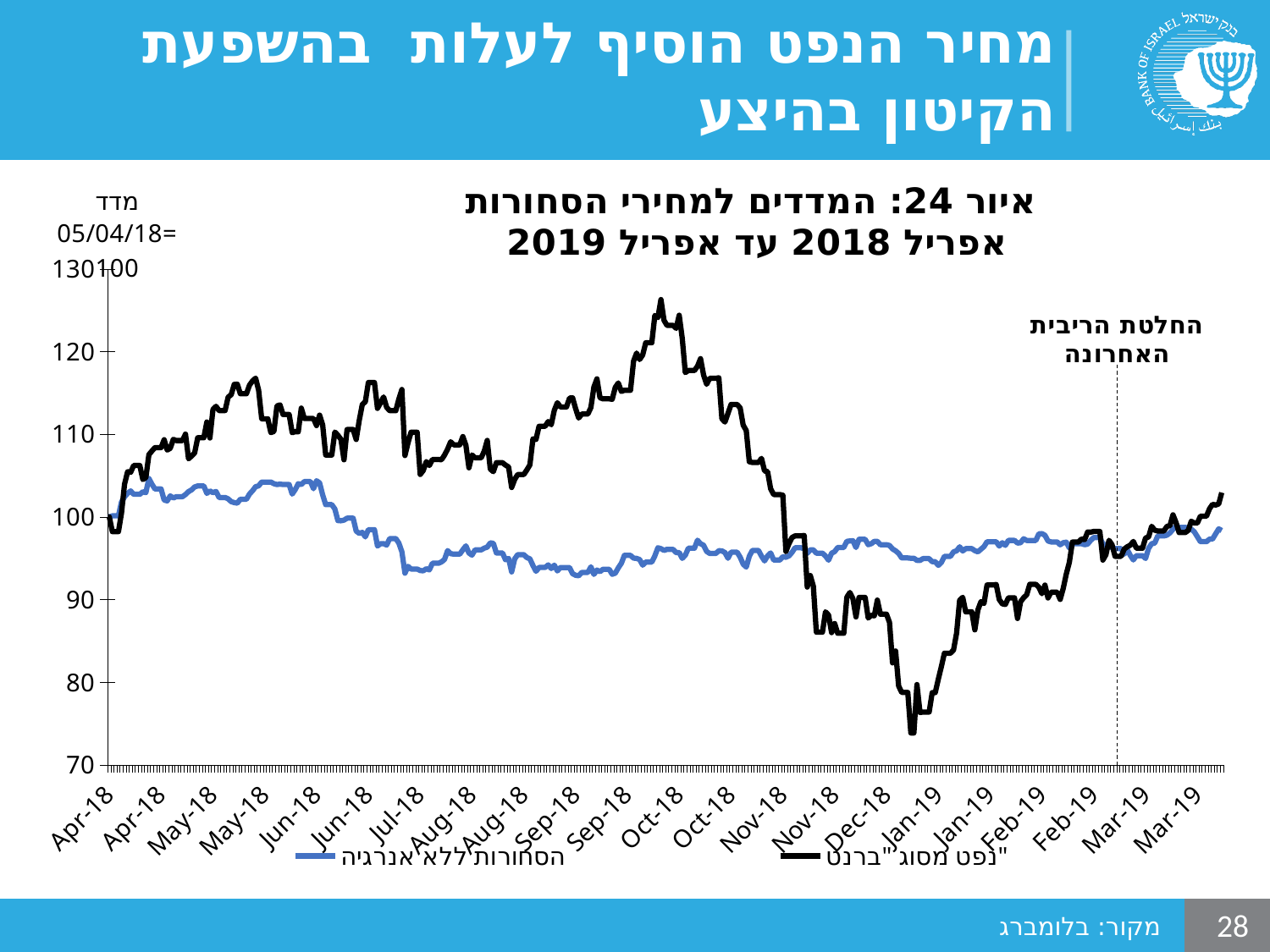
Which series is drawn with the black line? נפט מסוג "ברנט" What is the title of the chart? איור 24: המדדים למחירי הסחורות אפריל 2018 עד אפריל 2019 Does the Brent oil series rise or fall between Oct-18 and Dec-18? fall Is the peak value of the Brent oil (נפט מסוג "ברנט") series in Oct-18 greater or less than 120? greater In Oct-18, which series has the higher value: Brent oil or non-energy commodities? Brent oil (נפט מסוג "ברנט") In Dec-18, which series has the lower value: Brent oil or non-energy commodities? Brent oil (נפט מסוג "ברנט") Is the value of the non-energy commodities (הסחורות ללא אנרגיה) series in Jan-19 greater or less than 100? less What kind of chart is shown on the slide? line chart Does the Brent oil series rise or fall between Jan-19 and Mar-19? rise Is the lowest value of the Brent oil (נפט מסוג "ברנט") series in Dec-18 greater or less than 80? less How many series does the chart's legend list? 2